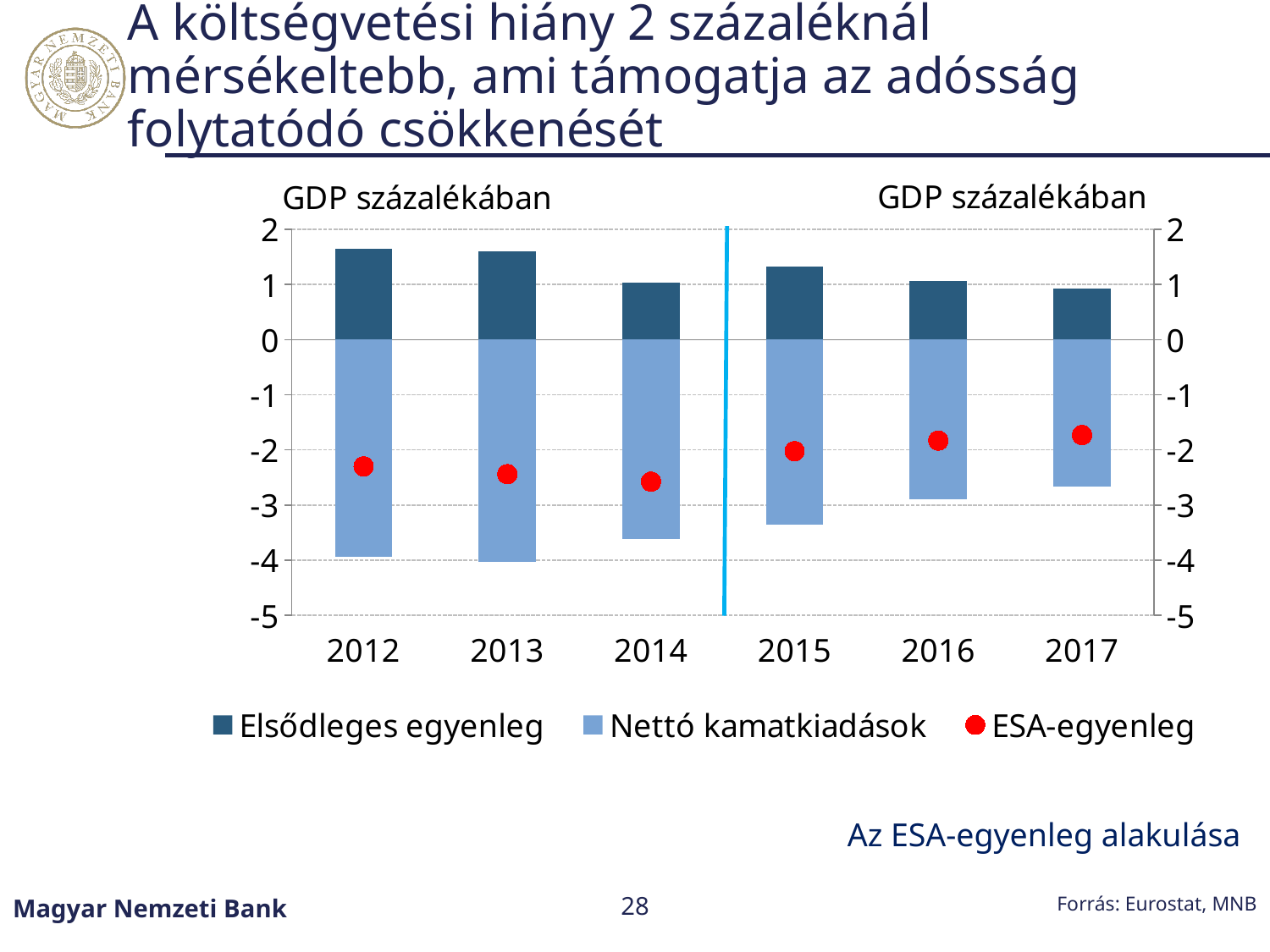
Does the ESA-egyenleg rise or fall from 2015 to 2017? rise In which year is the ESA-egyenleg marker at its highest (least negative) level? 2017 How many series does the chart legend list? 3 Is the ESA-egyenleg value for 2017 greater or less than -2? greater What unit label is shown above the chart's axes? GDP százalékában Is the value of Elsődleges egyenleg for 2012 greater or less than 1? greater In which year is the ESA-egyenleg marker at its lowest (most negative) level? 2014 How many years are shown on the x axis of the chart? 6 Is the value of Nettó kamatkiadások for 2014 greater or less than -4? greater Which year has the higher ESA-egyenleg value, 2012 or 2015? 2015 What kind of chart is shown on the slide? bar chart